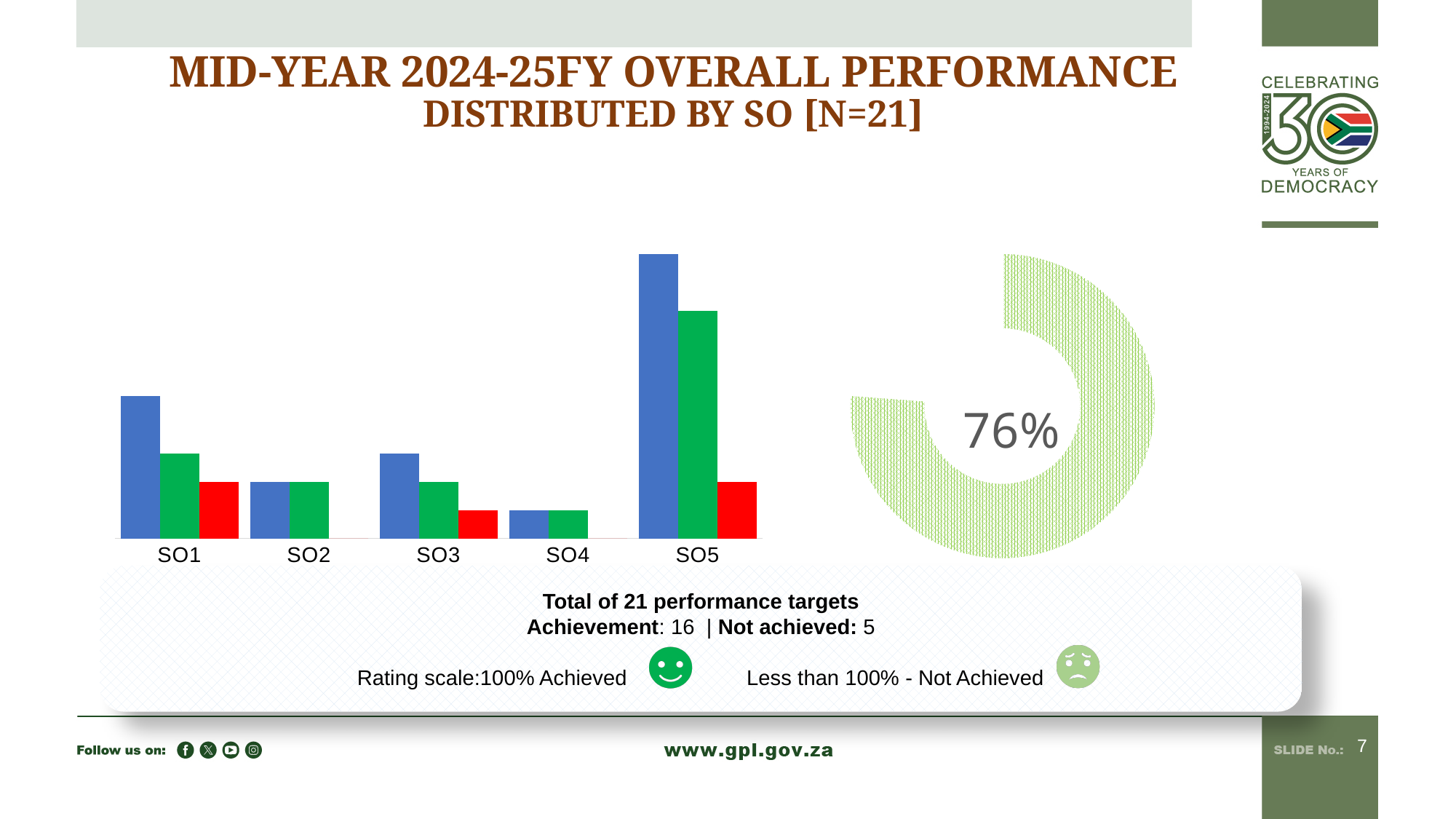
How many categories are shown on the x axis of the bar chart? 5 What kind of chart is the chart on the left of the slide? bar chart In the bar chart, is the blue bar for SO5 taller or shorter than the blue bar for SO1? taller What is the label of the first category on the x axis of the bar chart? SO1 What percentage is shown in the centre of the doughnut chart on the right? 76% What kind of chart is the chart on the right of the slide? doughnut chart In the bar chart, is the blue bar for SO1 taller or shorter than the blue bar for SO3? taller What colour is the tallest bar in the bar chart? blue In the bar chart, which category has the tallest blue bar? SO5 In the bar chart, which category has the shortest blue bar? SO4 In the bar chart, which category has the tallest green bar? SO5 In the bar chart, which category has the tallest red bar? SO1 and SO5 (tied)